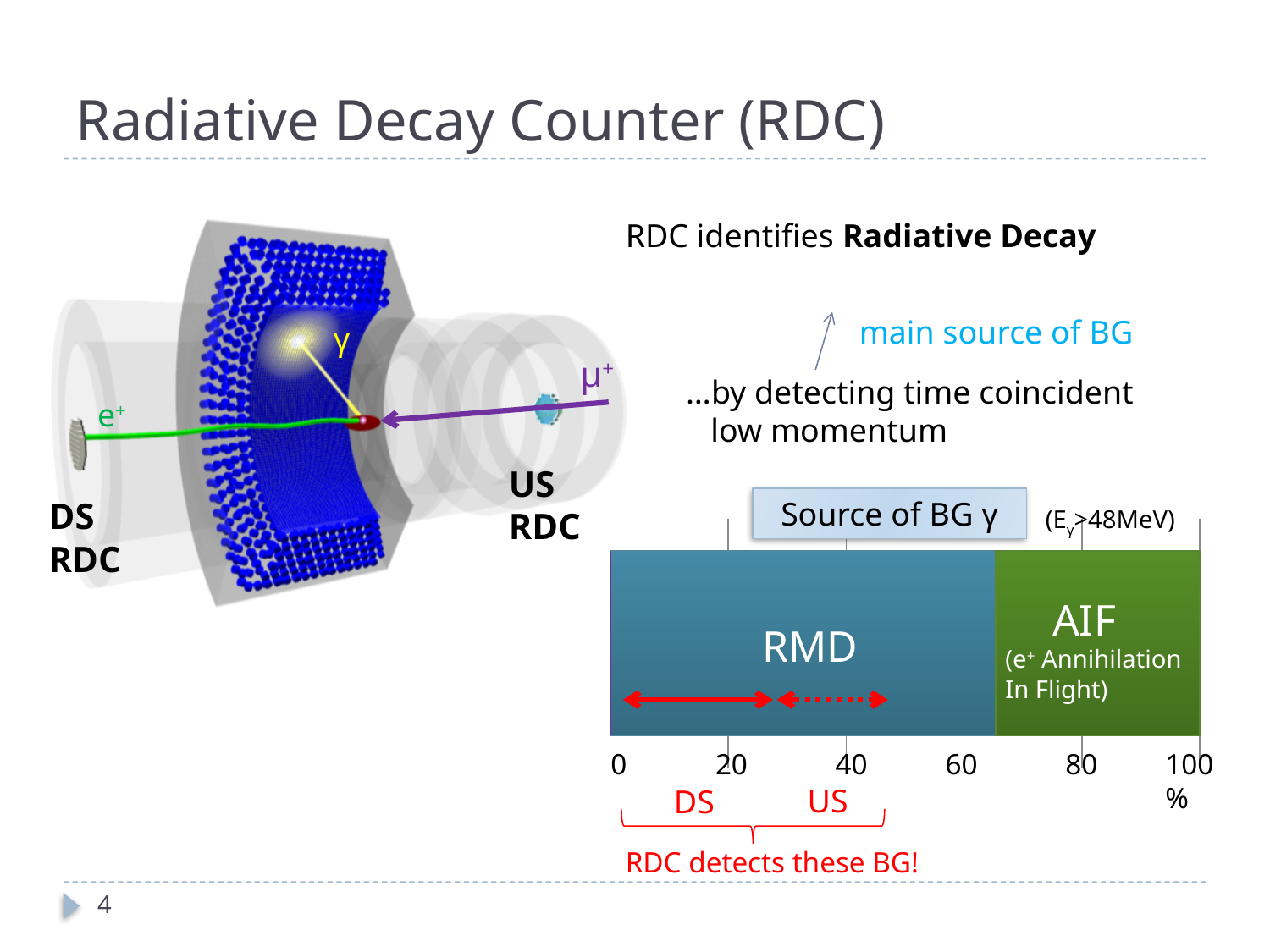
In the "Source of BG γ" chart, what does AIF stand for according to the label? e+ Annihilation In Flight In the "Source of BG γ" chart, which segment is larger, RMD or AIF? RMD What is the maximum value shown on the axis of the "Source of BG γ" chart? 100 In the "Source of BG γ" chart, is the share for RMD greater or less than 80? less In the "Source of BG γ" chart, is the share for RMD greater or less than 60? greater In the "Source of BG γ" chart, which source of background has the smallest share? AIF In the "Source of BG γ" chart, is the share for AIF greater or less than 20? greater What kind of chart is the "Source of BG γ" chart? bar chart How many segments make up the bar in the "Source of BG γ" chart? 2 What unit is shown on the axis of the "Source of BG γ" chart? % In the "Source of BG γ" chart, which source of background has the largest share? RMD